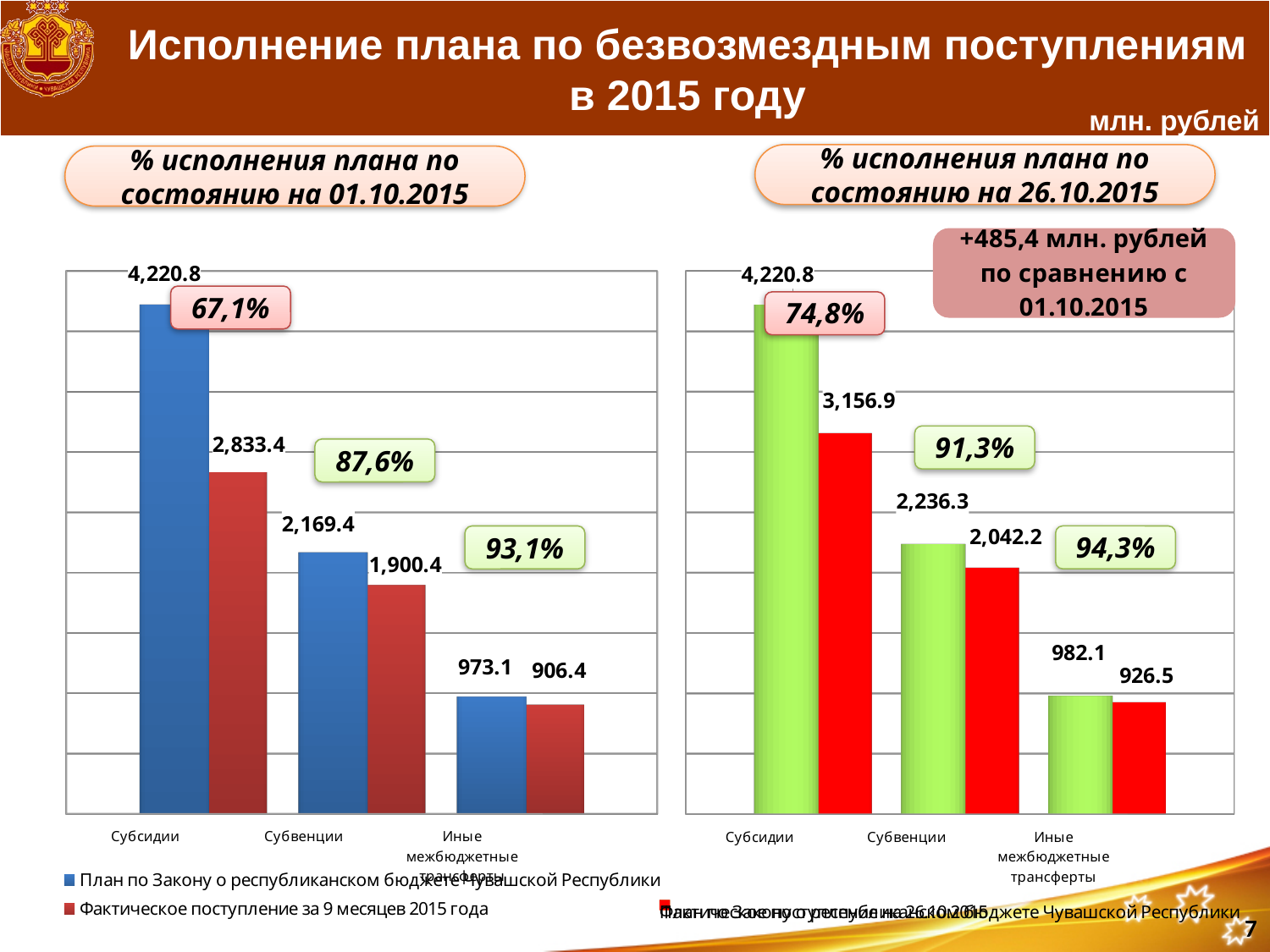
On the right chart (as of 26.10.2015), what is the plan value for Иные межбюджетные трансферты? 982.1 On the right chart (as of 26.10.2015), what is the difference between the plan and actual values for Субвенции? 194.1 On the right chart (as of 26.10.2015), which category has the highest plan value? Субсидии On the left chart (as of 01.10.2015), what is the actual receipt value for Субвенции? 1,900.4 On the left chart (as of 01.10.2015), what is the difference between the plan and actual values for Субсидии? 1,387.4 What type of chart is used on the right side of the slide? Bar chart On the right chart (as of 26.10.2015), what is the actual receipt value for Субсидии? 3,156.9 How many series does the legend of the left chart list? 2 Which is larger: the actual receipt for Субсидии on the left chart (01.10.2015) or on the right chart (26.10.2015)? Right chart (26.10.2015) On the left chart (as of 01.10.2015), what is the plan value for Субсидии? 4,220.8 On the left chart (as of 01.10.2015), which category has the lowest actual receipt value? Иные межбюджетные трансферты How many categories are shown on the left chart? 3